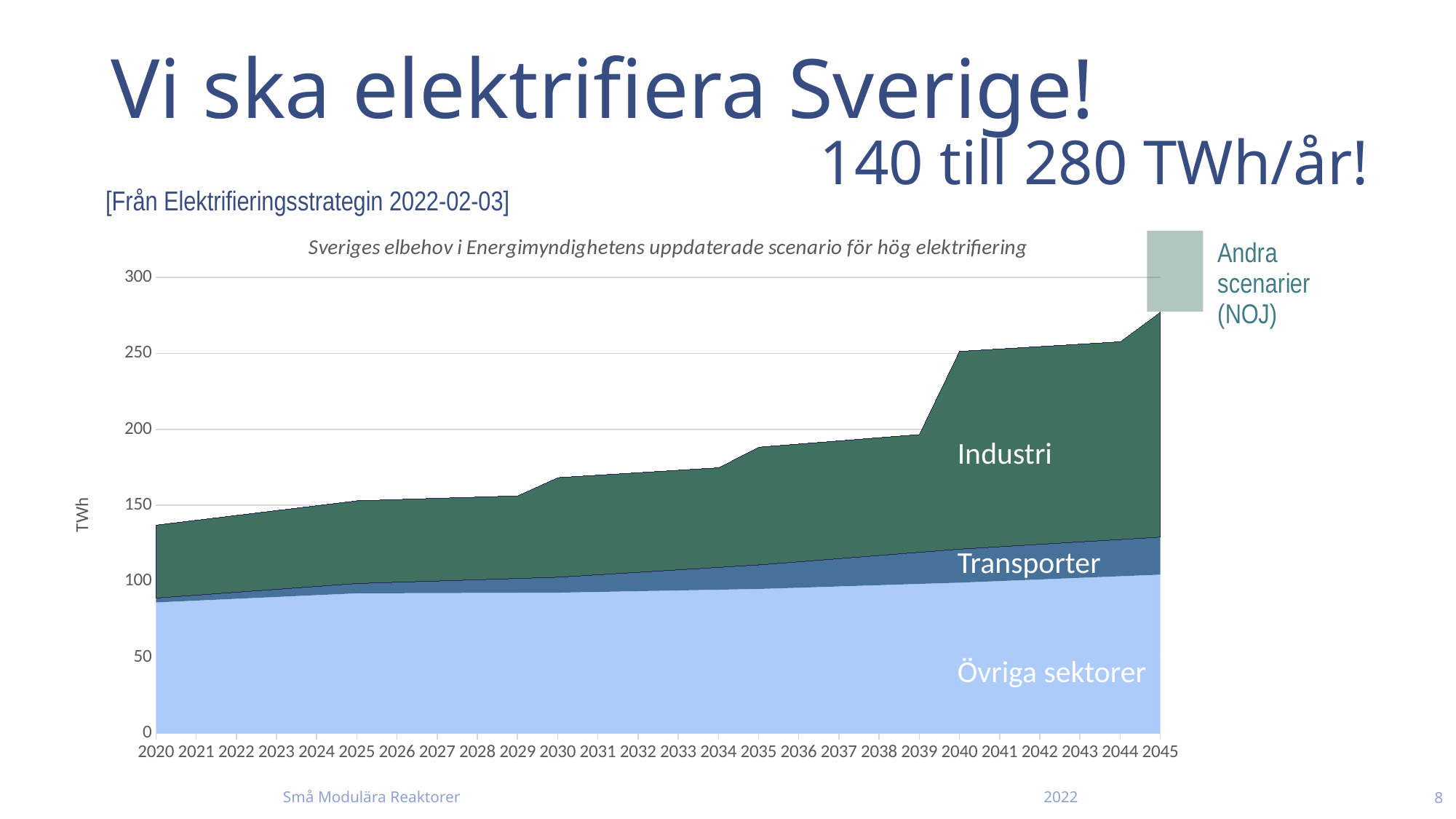
How many years are shown along the x axis of the chart? 26 Which is larger in 2045, the Industri area or the Övriga sektorer area? Industri How many sectors (series) are stacked in the chart? 3 Is the total value for 2020 greater or less than 150? less Which sector has the smallest share of the stacked area in 2045? Transporter Is the total value for 2035 greater or less than 200? less What kind of chart is shown on the slide? Area chart Is the total value for 2045 greater or less than 250? greater Does the total electricity demand in the chart rise or fall from 2020 to 2045? Rise What is the title of the chart? Sveriges elbehov i Energimyndighetens uppdaterade scenario för hög elektrifiering What unit is shown on the y axis of the chart? TWh